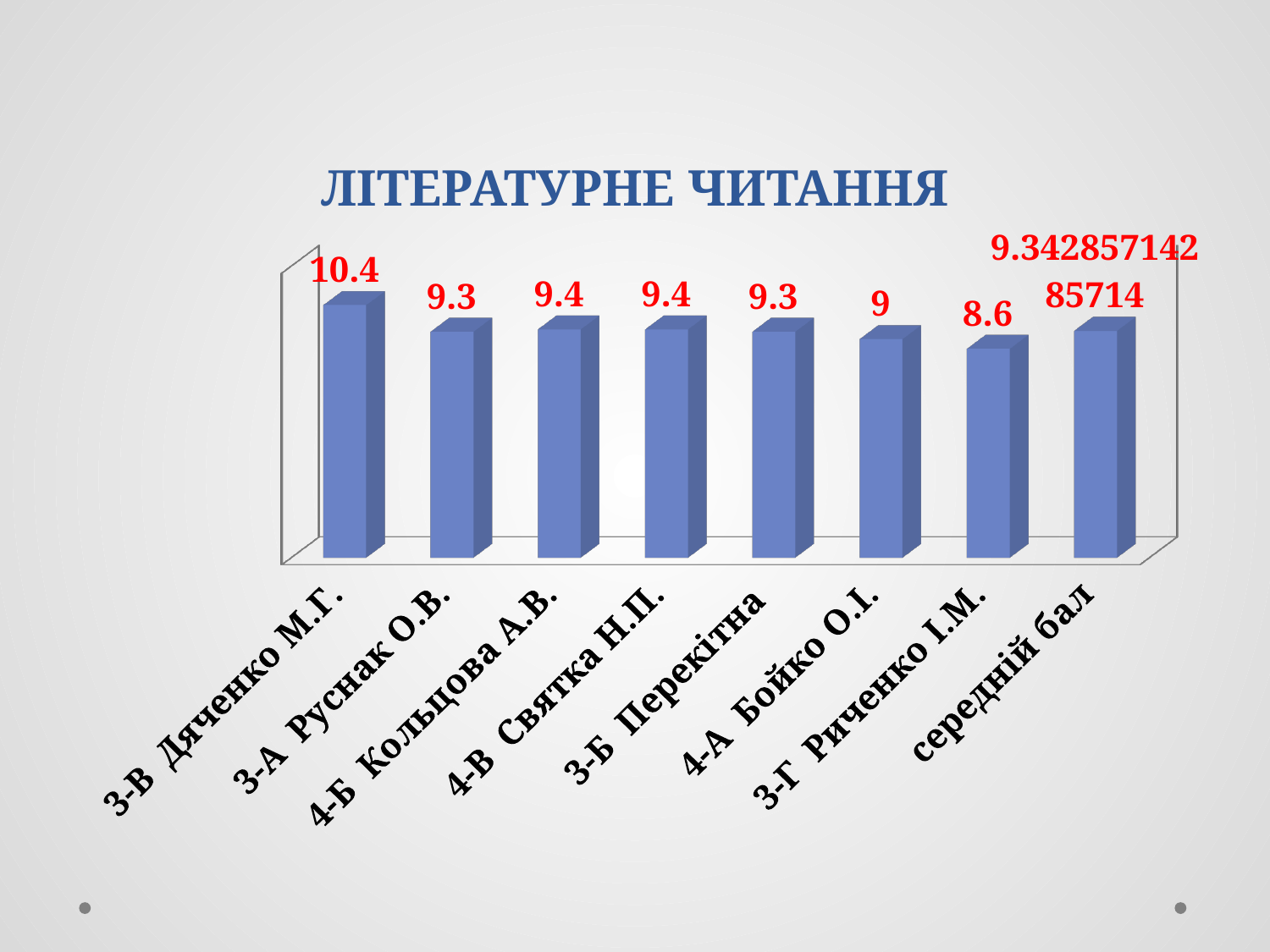
What is the value for 4-Б Кольцова А.В.? 9.4 Which is larger, the value for 3-А Руснак О.В. or the value for 4-А Бойко О.І.? 3-А Руснак О.В. What is the difference between the values for 3-В Дяченко М.Г. and 3-Г Риченко І.М.? 1.8 Which category has the highest value? 3-В Дяченко М.Г. What is the value for 4-А Бойко О.І.? 9 What is the value for 3-Г Риченко І.М.? 8.6 What kind of chart is shown on the slide? Bar chart What is the value shown for середній бал? 9.34285714285714 How many bars are shown in the chart? 8 Which category has the lowest value? 3-Г Риченко І.М. What is the title of the chart? ЛІТЕРАТУРНЕ ЧИТАННЯ What is the value for 3-В Дяченко М.Г.? 10.4